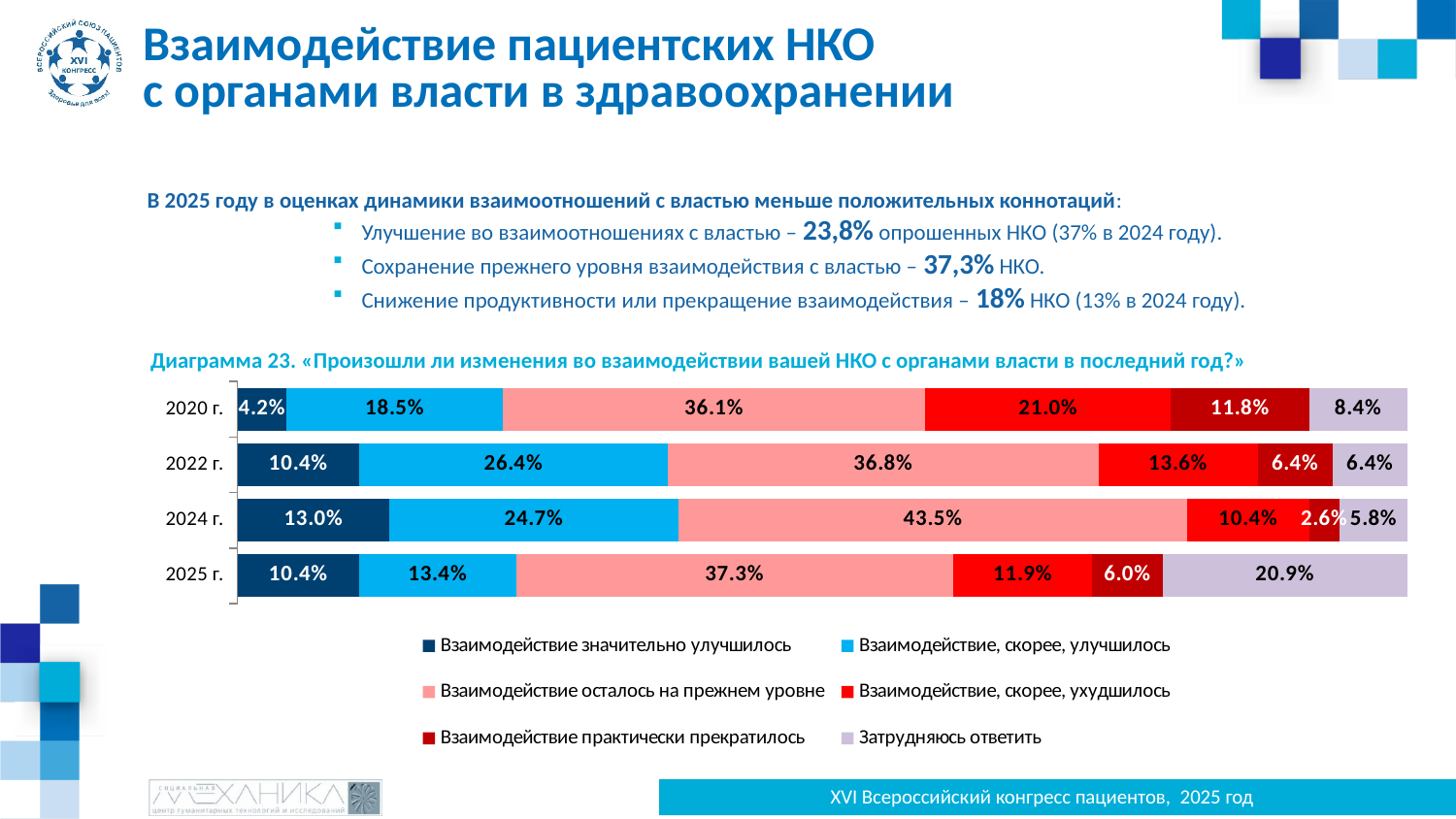
What type of chart is shown in Diagram 23? stacked bar chart Which is larger: "Взаимодействие, скорее, ухудшилось" in 2020 г. or in 2025 г.? 2020 г. How many series does the legend list? 6 What is the difference between the "Затрудняюсь ответить" values for 2025 г. and 2024 г.? 15.1% How many years (categories) are shown in the chart? 4 What is the value for "Затрудняюсь ответить" in 2024 г.? 5.8% In which year is the value for "Взаимодействие осталось на прежнем уровне" the highest? 2024 г. Does the value for "Взаимодействие, скорее, улучшилось" rise or fall from 2024 г. to 2025 г.? fall What is the value for "Взаимодействие осталось на прежнем уровне" in 2025 г.? 37.3% What is the value for "Взаимодействие, скорее, улучшилось" in 2022 г.? 26.4% In which year is the value for "Взаимодействие значительно улучшилось" the lowest? 2020 г. Which legend entry is shown in the lightest pink colour? Взаимодействие осталось на прежнем уровне